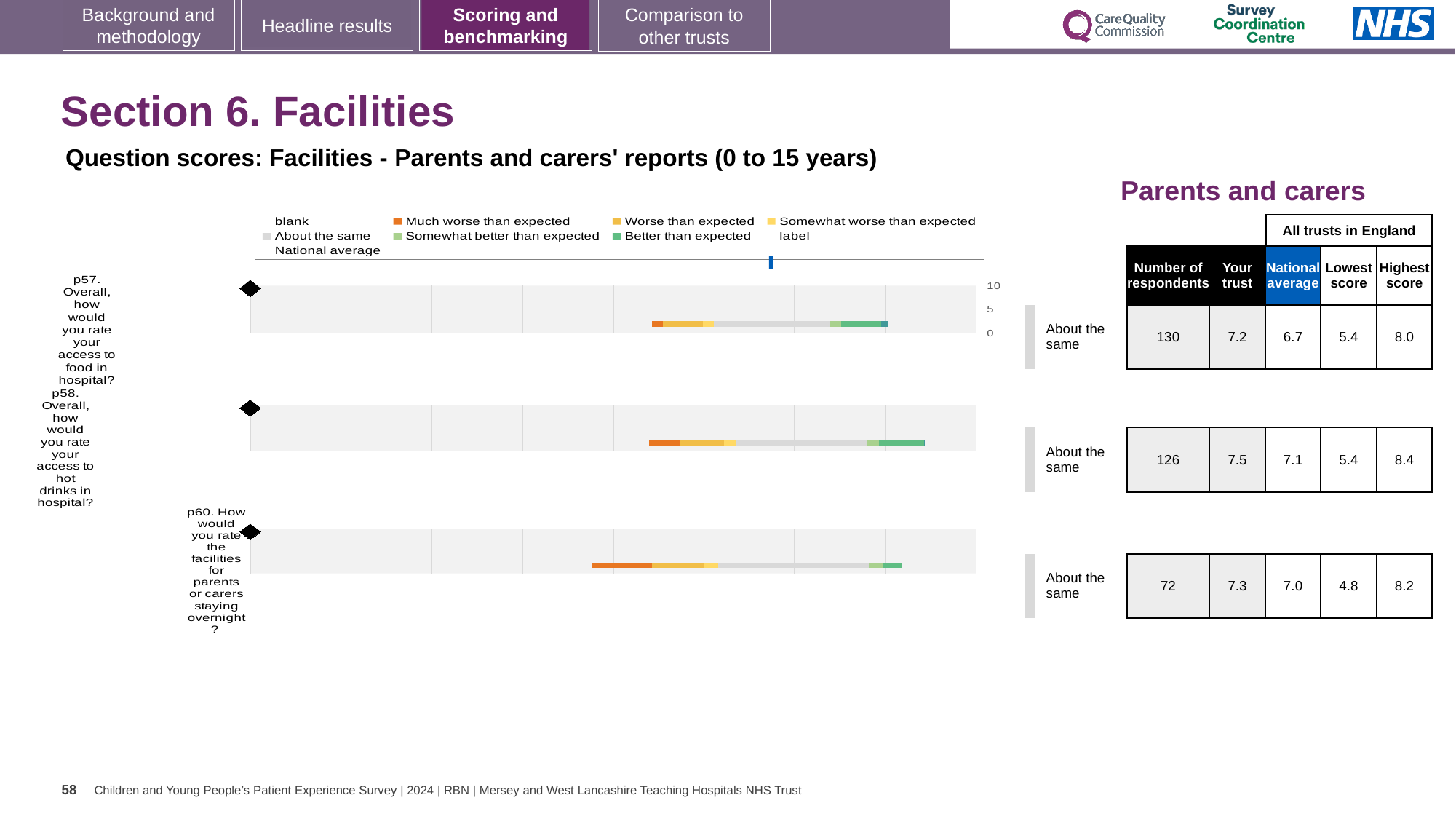
What is the difference between the 'Your trust' scores for p58 and p57? 0.3 What is the highest score among all trusts in England for p58? 8.4 What benchmark category is shown for p57 (access to food in hospital)? About the same Which question has the highest 'Your trust' score? p58. Overall, how would you rate your access to hot drinks in hospital? How many questions (categories) are plotted in the chart? 3 What is the 'Your trust' score for p57 (access to food in hospital)? 7.2 Which question has the lowest number of respondents? p60. How would you rate the facilities for parents or carers staying overnight? What is the title of the chart section shown on the slide? Question scores: Facilities - Parents and carers' reports (0 to 15 years) For p60, which is larger: the 'Your trust' score or the national average? Your trust How many respondents answered p60 (facilities for parents or carers staying overnight)? 72 What is the national average score for p58 (access to hot drinks in hospital)? 7.1 What kind of chart is used to show the question scores on this slide? bar chart